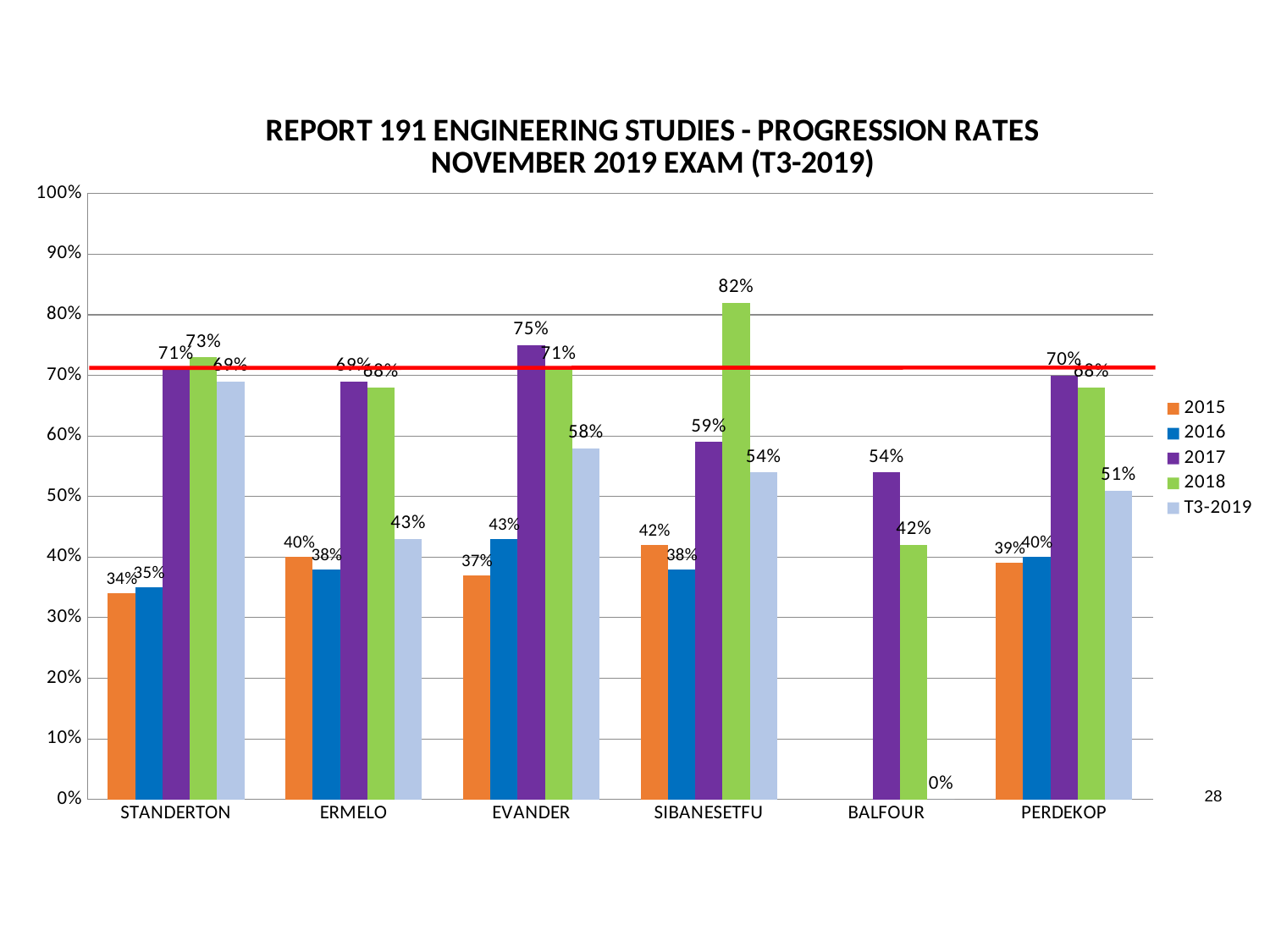
How many series does the legend list? 5 Which is larger, the T3-2019 value for EVANDER or the T3-2019 value for PERDEKOP? EVANDER What is the 2018 value for SIBANESETFU? 82% What kind of chart is shown on the slide? Bar chart What is the T3-2019 value for BALFOUR? 0% What is the 2017 value for EVANDER? 75% What is the difference between the 2018 and 2017 values for SIBANESETFU? 23% Which campus has the lowest T3-2019 value? BALFOUR Which series is shown in green in the legend? 2018 How many campuses are shown on the x axis? 6 Which campus has the highest 2018 value? SIBANESETFU What is the 2015 value for ERMELO? 40%